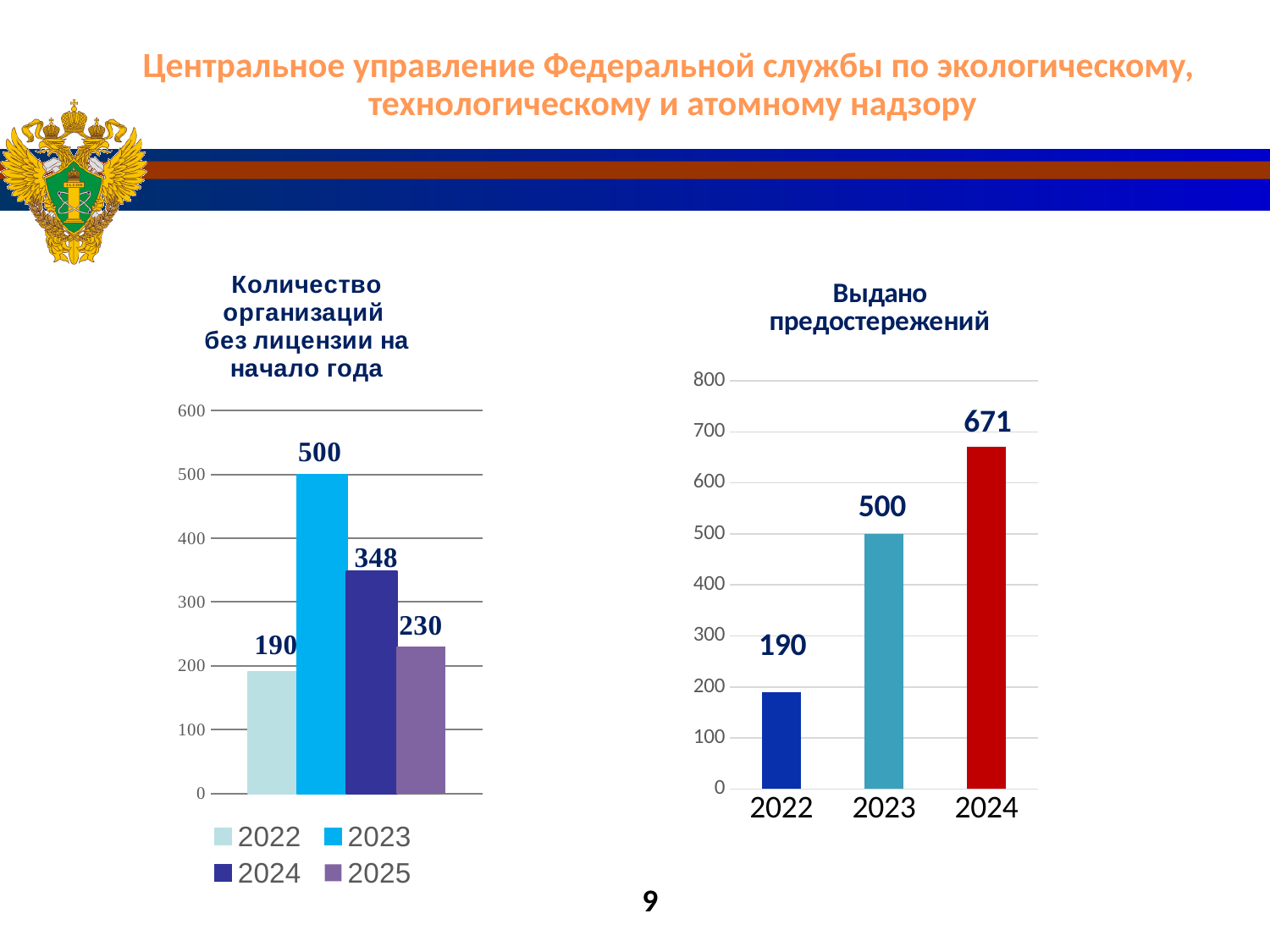
In the chart titled 'Выдано предостережений', what is the value for 2024? 671 In the chart titled 'Выдано предостережений', which year has the highest value? 2024 In the chart titled 'Выдано предостережений', do the values rise or fall from 2022 to 2024? rise In the chart titled 'Выдано предостережений', what is the difference between the values for 2024 and 2023? 171 In the chart titled 'Количество организаций без лицензии на начало года', what is the difference between the values for 2024 and 2025? 118 In the chart titled 'Выдано предостережений', what is the value for 2022? 190 In the chart titled 'Выдано предостережений', how many years are shown on the x axis? 3 In the chart titled 'Количество организаций без лицензии на начало года', how many series does the legend list? 4 What kind of chart is the chart titled 'Выдано предостережений'? bar chart In the chart titled 'Количество организаций без лицензии на начало года', what is the value for 2023? 500 In the chart titled 'Количество организаций без лицензии на начало года', which year has the lowest value? 2022 In the chart titled 'Количество организаций без лицензии на начало года', what is the value for 2025? 230